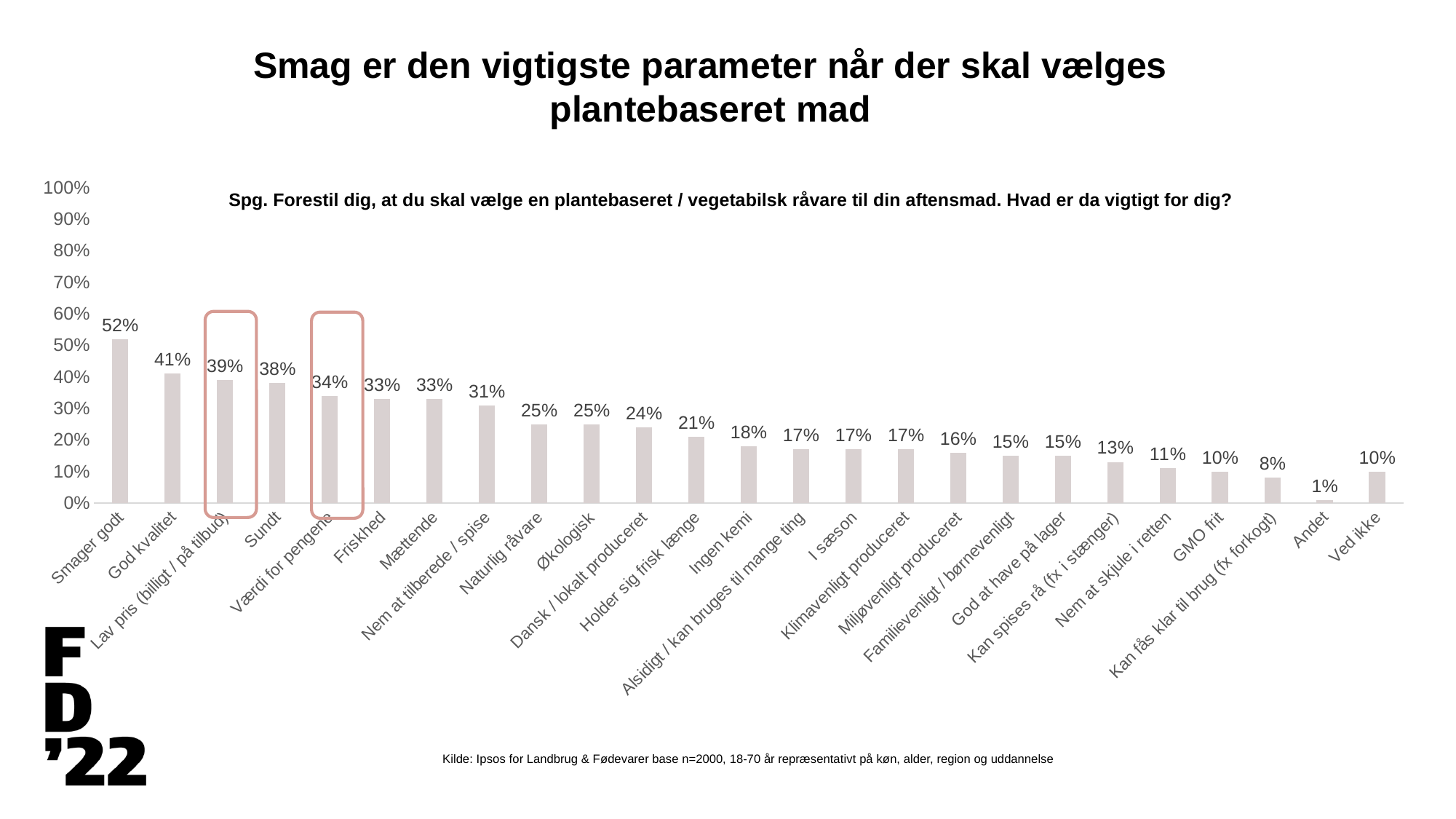
How many categories are shown on the x axis? 25 Which category has the lowest value? Andet Which two bars are highlighted with a rounded outline? Lav pris (billigt / på tilbud) and Værdi for pengene Which is larger, Sundt or Friskhed? Sundt Is the value for Naturlig råvare greater or less than 30%? less What is the value for Smager godt? 52% What is the value for GMO frit? 10% What is the value for Værdi for pengene? 34% What kind of chart is shown? Bar chart What is the value for Økologisk? 25% Which category has the highest value? Smager godt What is the difference between Smager godt and God kvalitet? 11%